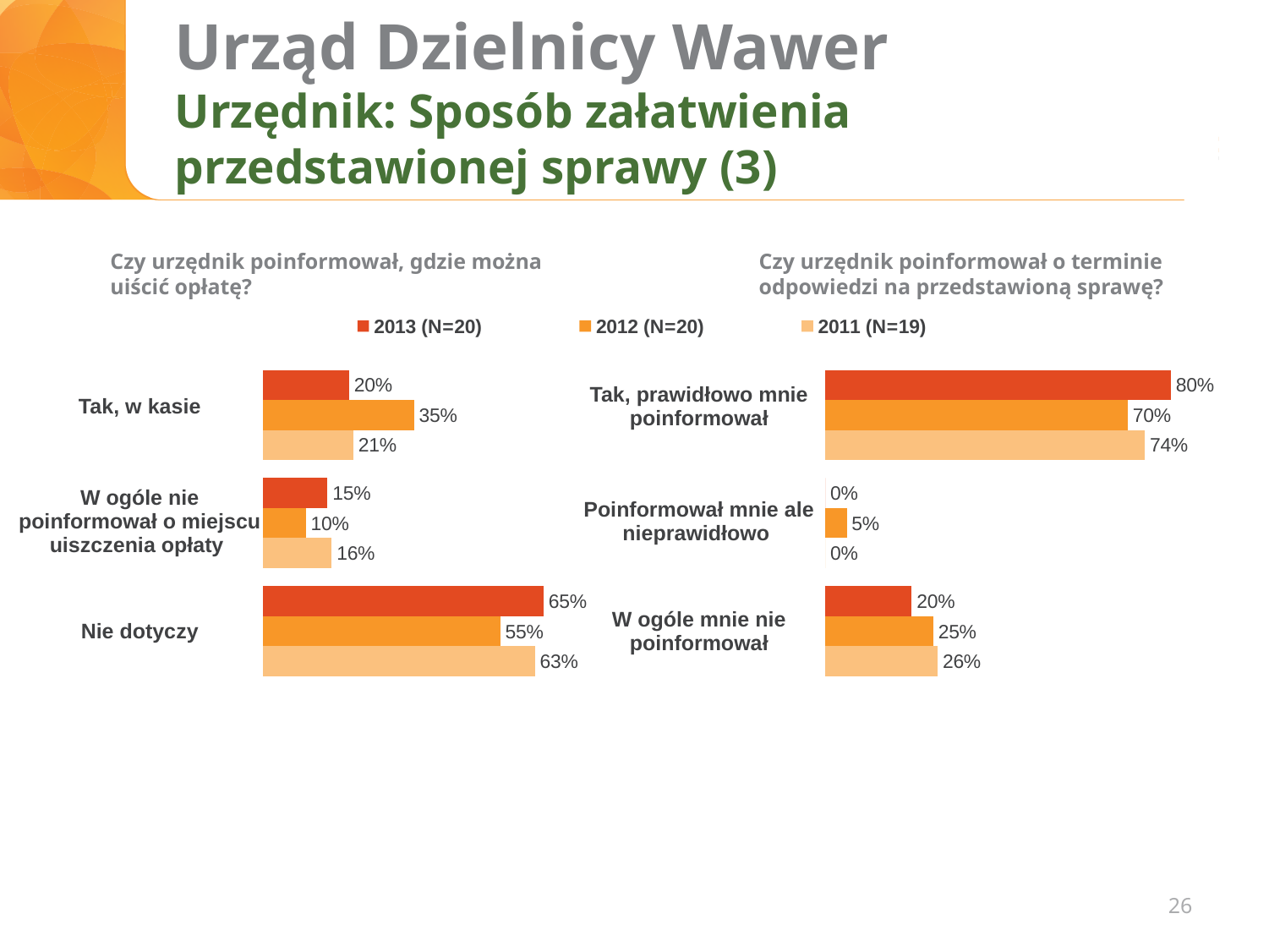
In the left chart ('Czy urzędnik poinformował, gdzie można uiścić opłatę?'), what is the value for 'Nie dotyczy' in 2012 (N=20)? 55% In the right chart ('Czy urzędnik poinformował o terminie odpowiedzi na przedstawioną sprawę?'), what is the value for 'Tak, prawidłowo mnie poinformował' in 2011 (N=19)? 74% In the left chart ('Czy urzędnik poinformował, gdzie można uiścić opłatę?'), what is the value for 'Tak, w kasie' in 2013 (N=20)? 20% How many series does the legend list? 3 What kind of chart is the left chart ('Czy urzędnik poinformował, gdzie można uiścić opłatę?')? Bar chart Which legend entry is shown in the darkest red-orange colour? 2013 (N=20) In the right chart ('Czy urzędnik poinformował o terminie odpowiedzi na przedstawioną sprawę?'), what is the difference between the 2013 (N=20) and 2012 (N=20) values for 'Tak, prawidłowo mnie poinformował'? 10 percentage points In the left chart ('Czy urzędnik poinformował, gdzie można uiścić opłatę?'), which is larger for 'Tak, w kasie': the 2012 (N=20) value or the 2011 (N=19) value? 2012 (N=20) How many categories does the right chart ('Czy urzędnik poinformował o terminie odpowiedzi na przedstawioną sprawę?') show? 3 In the left chart ('Czy urzędnik poinformował, gdzie można uiścić opłatę?'), which category has the highest value for 2013 (N=20)? Nie dotyczy In the right chart ('Czy urzędnik poinformował o terminie odpowiedzi na przedstawioną sprawę?'), which category has the lowest value for 2013 (N=20)? Poinformował mnie ale nieprawidłowo In the right chart ('Czy urzędnik poinformował o terminie odpowiedzi na przedstawioną sprawę?'), what is the value for 'Poinformował mnie ale nieprawidłowo' in 2012 (N=20)? 5%